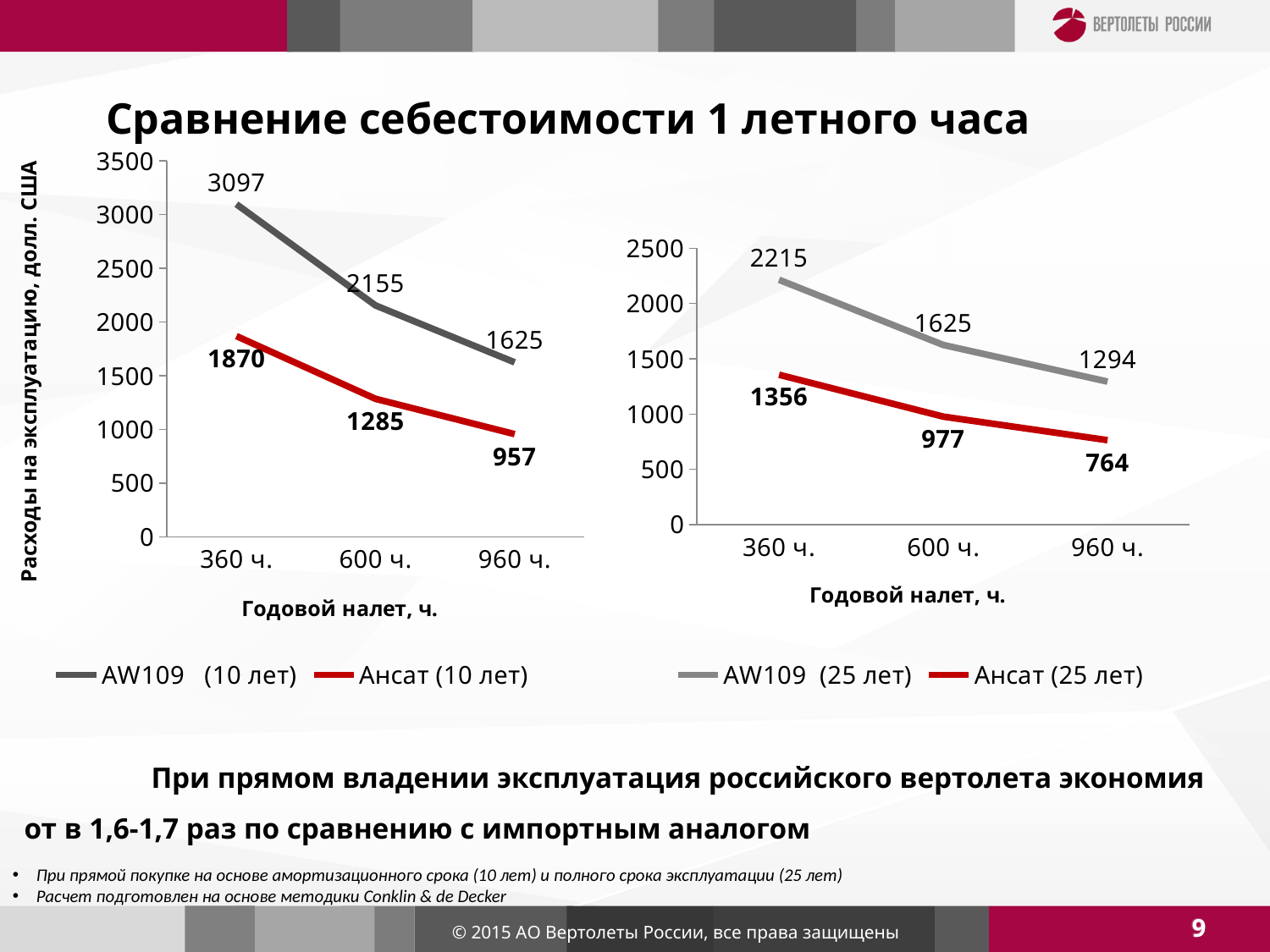
In the right chart (25 лет), what is the difference between AW109 and Ансат at 960 ч.? 530 In the right chart (25 лет), what is the value for AW109 at 600 ч.? 1625 In the left chart (10 лет), what is the value for AW109 at 360 ч.? 3097 In the left chart (10 лет), at which annual flight hours value is the Ансат cost lowest? 960 ч. In the left chart (10 лет), what is the value for Ансат at 960 ч.? 957 How many series does the legend of the left chart (10 лет) list? 2 In the left chart (10 лет), what is the difference between AW109 and Ансат at 600 ч.? 870 What type of chart is the left chart (10 лет)? line chart In the left chart (10 лет), do the AW109 values rise or fall as annual flight hours increase? fall In the right chart (25 лет), what is the value for Ансат at 360 ч.? 1356 How many x-axis categories does the right chart (25 лет) have? 3 In the right chart (25 лет), which series has the higher value at 360 ч., AW109 or Ансат? AW109